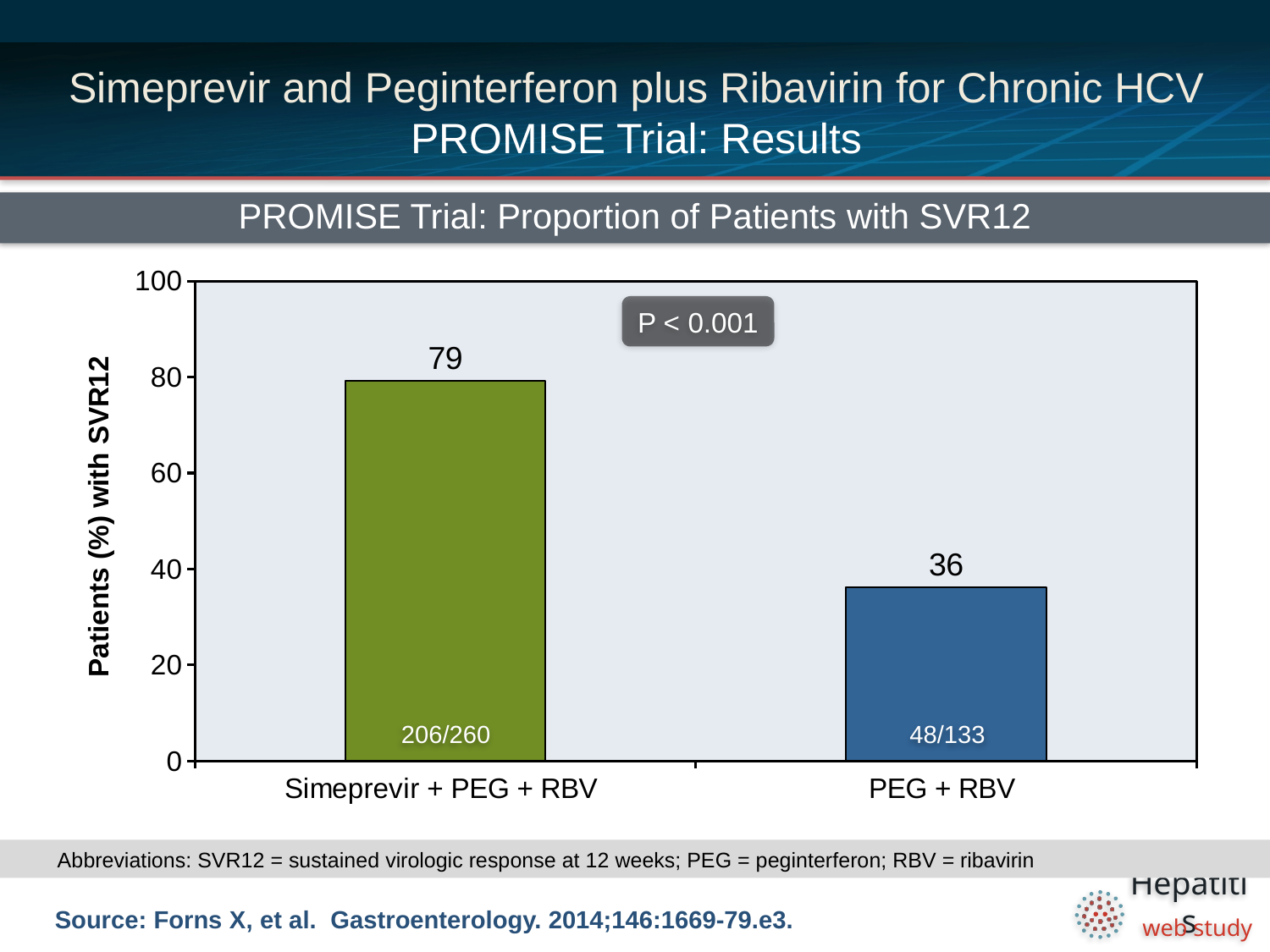
What is the SVR12 rate for Simeprevir + PEG + RBV? 79 What fraction of patients is printed inside the PEG + RBV bar? 48/133 Which arm has a larger SVR12 rate, Simeprevir + PEG + RBV or PEG + RBV? Simeprevir + PEG + RBV Which treatment arm has the highest proportion of patients with SVR12? Simeprevir + PEG + RBV What is the SVR12 rate for PEG + RBV? 36 What kind of chart is shown on the slide? Bar chart Is the value for PEG + RBV greater or less than 40? less What P value is shown on the chart? P < 0.001 What is the difference in SVR12 rate between Simeprevir + PEG + RBV and PEG + RBV? 43 How many treatment arms are shown in the chart? 2 Which treatment arm has the lowest proportion of patients with SVR12? PEG + RBV What fraction of patients is printed inside the Simeprevir + PEG + RBV bar? 206/260